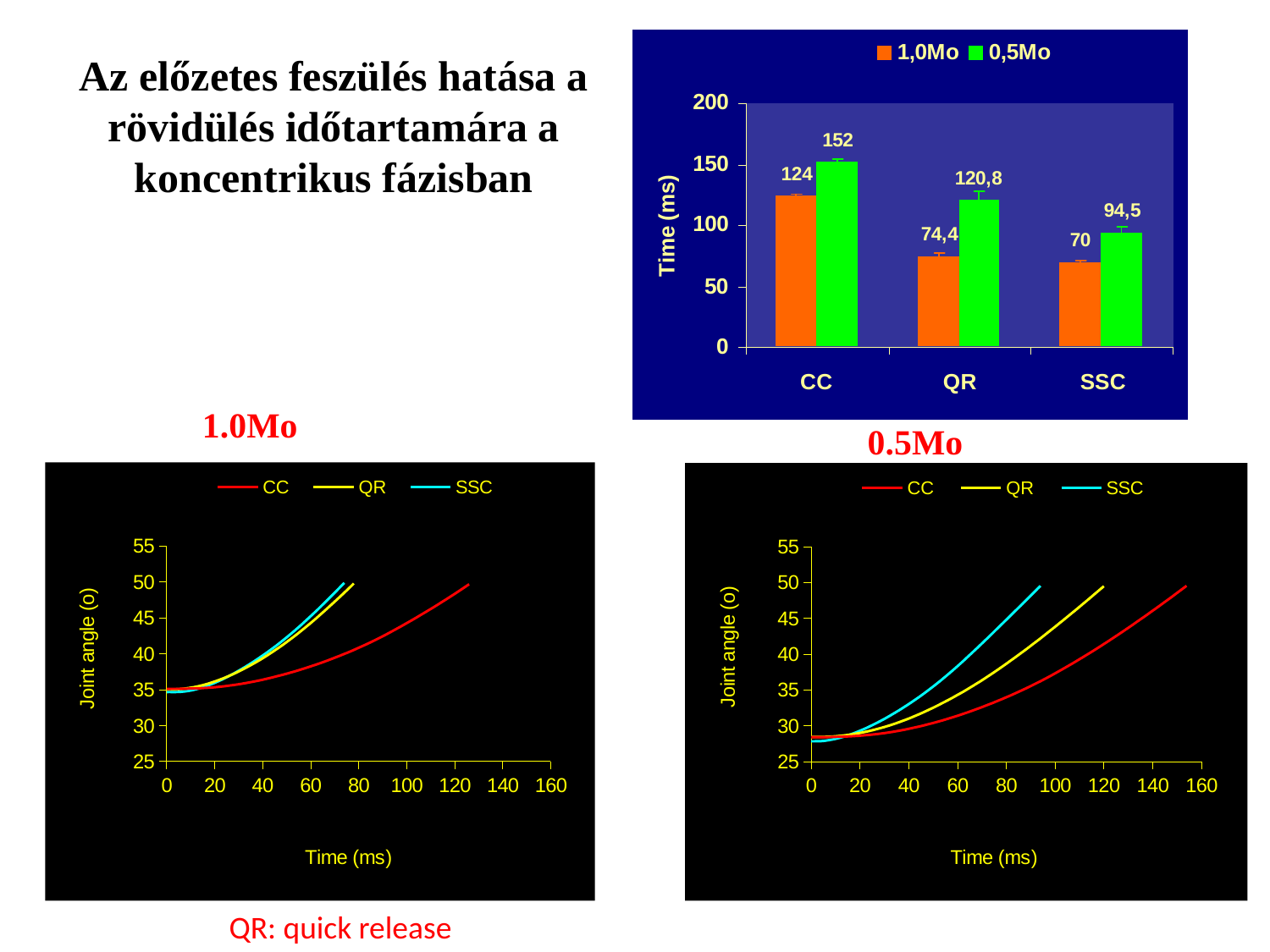
In the bar chart at the top right, what is the difference between the 0,5Mo and 1,0Mo values for CC? 28 In the bar chart at the top right, what is the value for CC in the 1,0Mo series? 124 In the bar chart at the top right, which category has the lowest value in the 1,0Mo series? SSC How many series does the legend of the bar chart at the top right list? 2 In the 0.5Mo chart at the bottom right, does the joint angle rise or fall as time increases? rise In the bar chart at the top right, which is larger for QR: the 1,0Mo value or the 0,5Mo value? 0,5Mo How many categories are shown on the x axis of the bar chart at the top right? 3 In the bar chart at the top right, what is the difference between the 0,5Mo and 1,0Mo values for SSC? 24,5 In the bar chart at the top right, what is the value for QR in the 0,5Mo series? 120,8 In the bar chart at the top right, what is the value for SSC in the 1,0Mo series? 70 What kind of chart is the 1.0Mo chart at the bottom left? line chart In the bar chart at the top right, which category has the highest value in the 0,5Mo series? CC